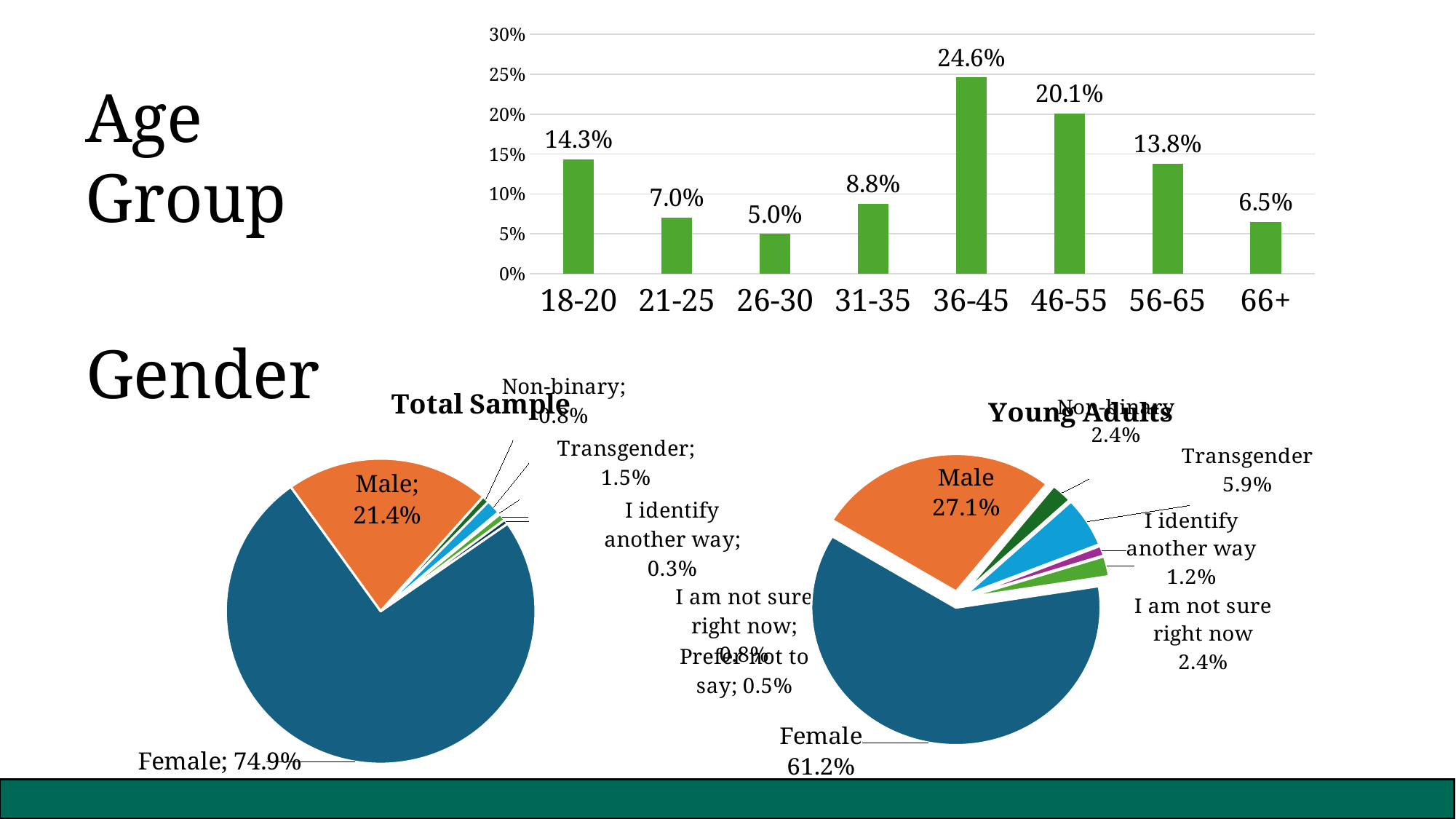
In the Age Group chart, which is larger, the value for 18-20 or the value for 31-35? 18-20 In the Age Group chart, which age group has the highest percentage? 36-45 What type of chart is the Age Group chart? Bar chart How many age groups are shown in the Age Group bar chart? 8 In the Age Group chart, which age group has the lowest percentage? 26-30 In the Young Adults pie chart, what percentage is shown for Transgender? 5.9% Which is larger, the Male share in the Total Sample pie chart or the Male share in the Young Adults pie chart? Young Adults In the Young Adults pie chart, what is the difference between the Female and Male shares? 34.1% In the Total Sample pie chart, what share is Female? 74.9% In the Age Group chart, what is the difference between the percentages for 46-55 and 56-65? 6.3% In the Age Group chart, what percentage is shown for the 66+ age group? 6.5% In the Age Group chart, what percentage is shown for the 36-45 age group? 24.6%